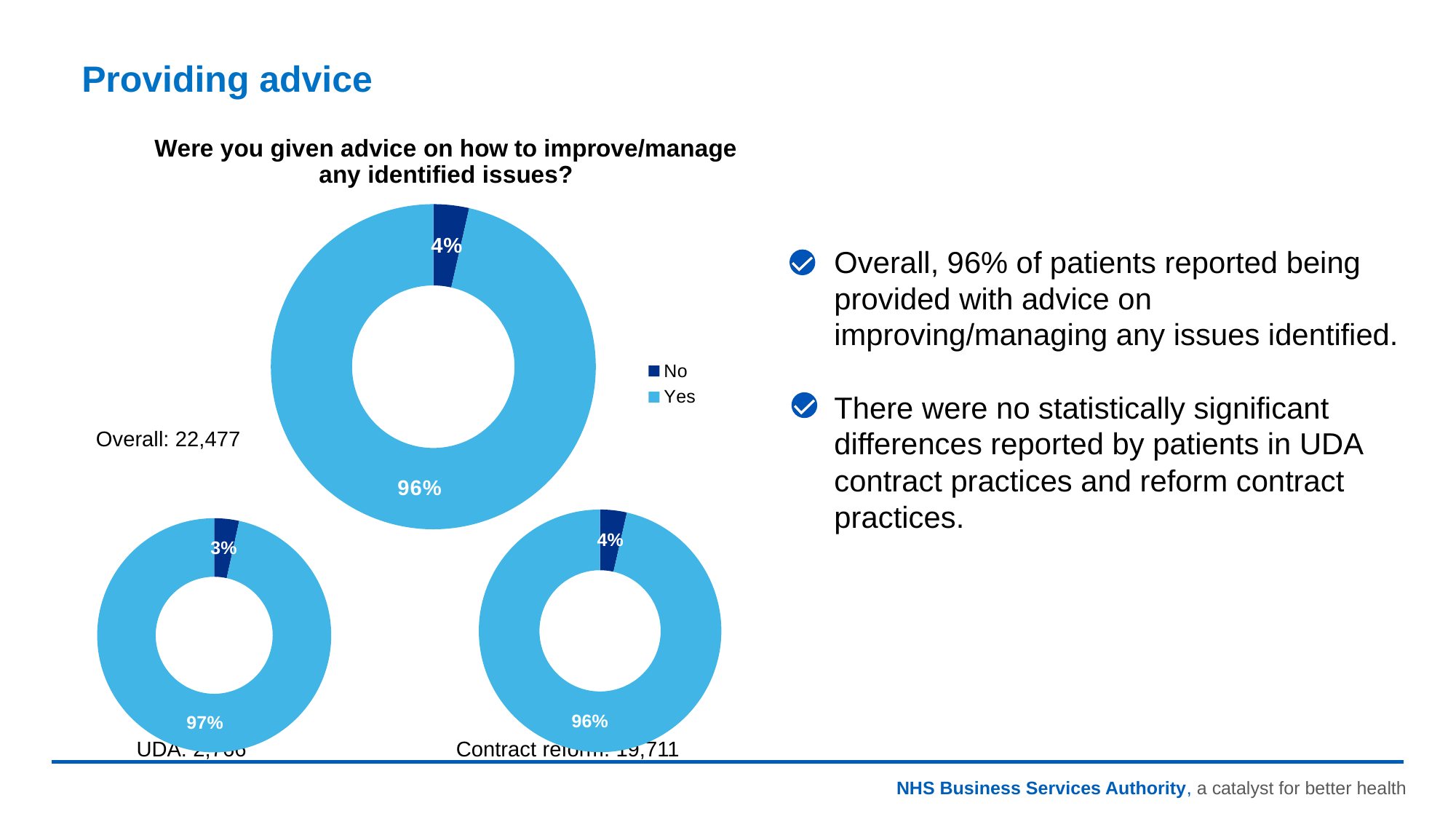
What is the title of the chart on this slide? Were you given advice on how to improve/manage any identified issues? In the Overall doughnut chart, which response has the larger share, Yes or No? Yes In the UDA doughnut chart, what percentage of patients answered Yes? 97% In the UDA doughnut chart, what percentage of patients answered No? 3% How many entries does the legend list for the charts on this slide? 2 How many respondents are shown for the Overall doughnut chart? 22,477 In the Overall doughnut chart, what is the difference in percentage points between the Yes and No shares? 92 What type of chart is used on this slide to show the responses? Doughnut chart In the Overall doughnut chart, what percentage of patients answered No? 4% In the Overall doughnut chart, what percentage of patients answered Yes? 96% In the Contract reform doughnut chart, what percentage of patients answered No? 4% In the Contract reform doughnut chart, what percentage of patients answered Yes? 96%